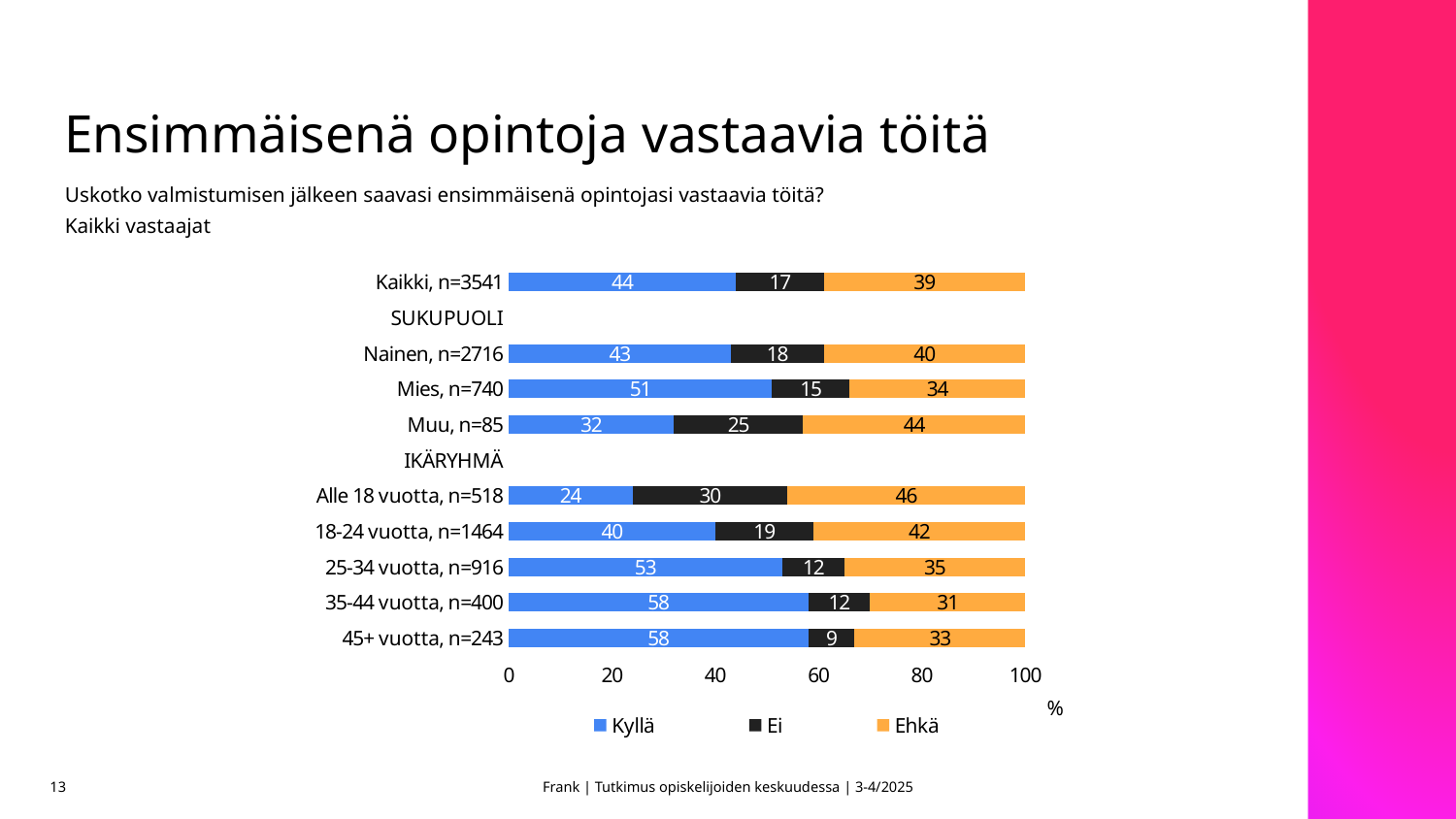
What kind of chart is shown on the slide? Stacked bar chart What is the Ehkä value for Alle 18 vuotta, n=518? 46 Which category has the highest Ei value? Alle 18 vuotta, n=518 How many series does the legend list? 3 Which category has the lowest Kyllä value? Alle 18 vuotta, n=518 What is the Ei value for Muu, n=85? 25 What is the Ei value for 45+ vuotta, n=243? 9 What are the three legend entries of the chart? Kyllä, Ei, Ehkä What is the total of the stacked bar for 35-44 vuotta, n=400? 101 What is the difference between the Kyllä values for Mies, n=740 and Nainen, n=2716? 8 Which is larger, the Ehkä value for 18-24 vuotta, n=1464 or the Ehkä value for 25-34 vuotta, n=916? 18-24 vuotta, n=1464 What is the Kyllä value for Kaikki, n=3541? 44